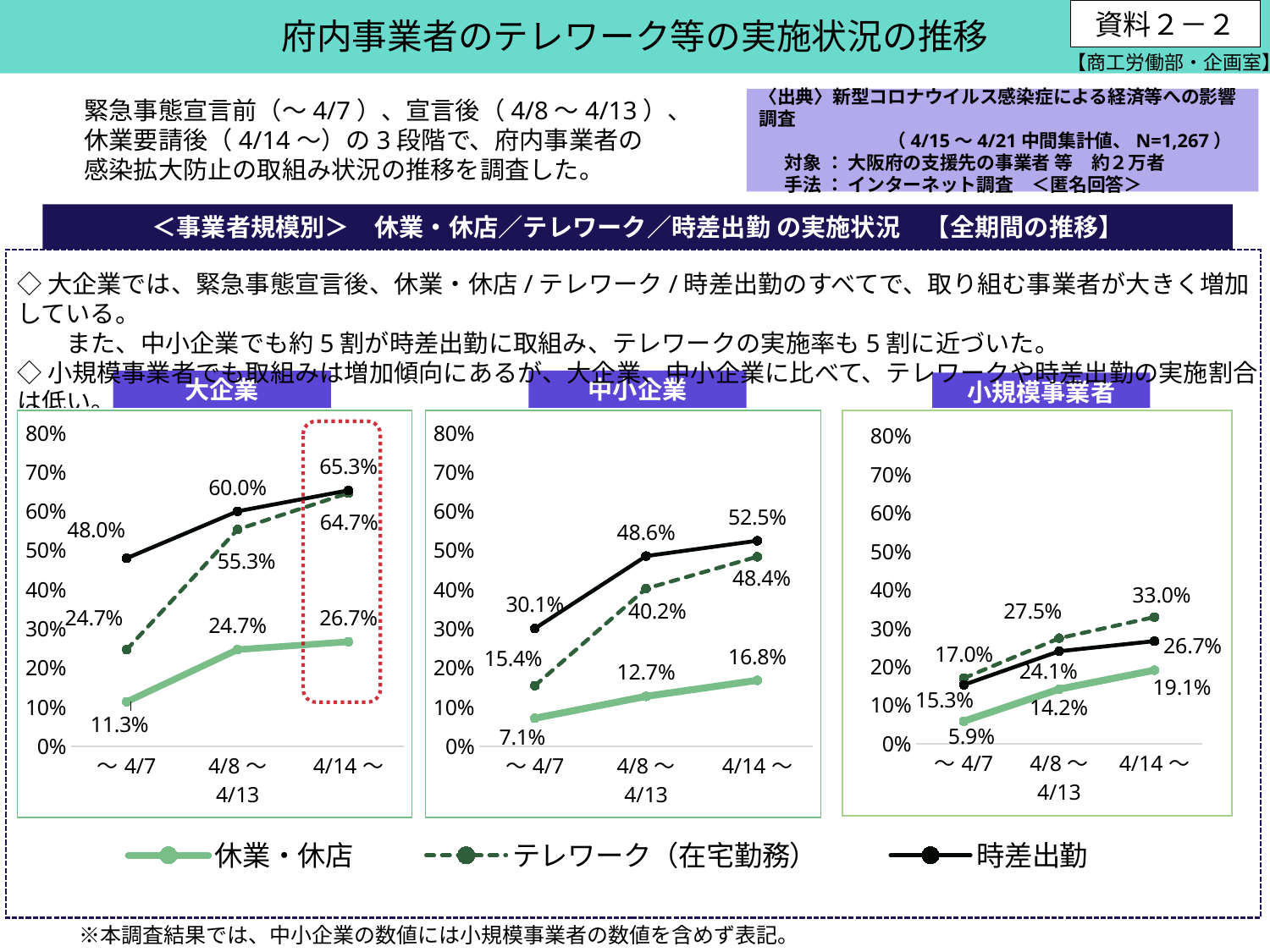
In the 小規模事業者 chart, what is the value of 休業・休店 for the 4/14～ period? 19.1% In the 大企業 chart, what is the difference between 時差出勤 and 休業・休店 for the 4/8～4/13 period? 35.3% In the 中小企業 chart, which is larger for the 4/14～ period: 時差出勤 or テレワーク（在宅勤務）? 時差出勤 How many series does the legend list? 3 In the 中小企業 chart, which series has the lowest value for the ～4/7 period? 休業・休店 In the 小規模事業者 chart, does the 時差出勤 series rise or fall from ～4/7 to 4/14～? Rise In the 小規模事業者 chart, which series has the highest value for the 4/14～ period? テレワーク（在宅勤務） In the 中小企業 chart, what is the value of テレワーク（在宅勤務） for the 4/8～4/13 period? 40.2% In the 大企業 chart, what is the value of 休業・休店 for the ～4/7 period? 11.3% What kind of chart is the 中小企業 chart? Line chart In the 大企業 chart, what is the value of 時差出勤 for the 4/14～ period? 65.3% How many periods are shown on the x axis of the 大企業 chart? 3